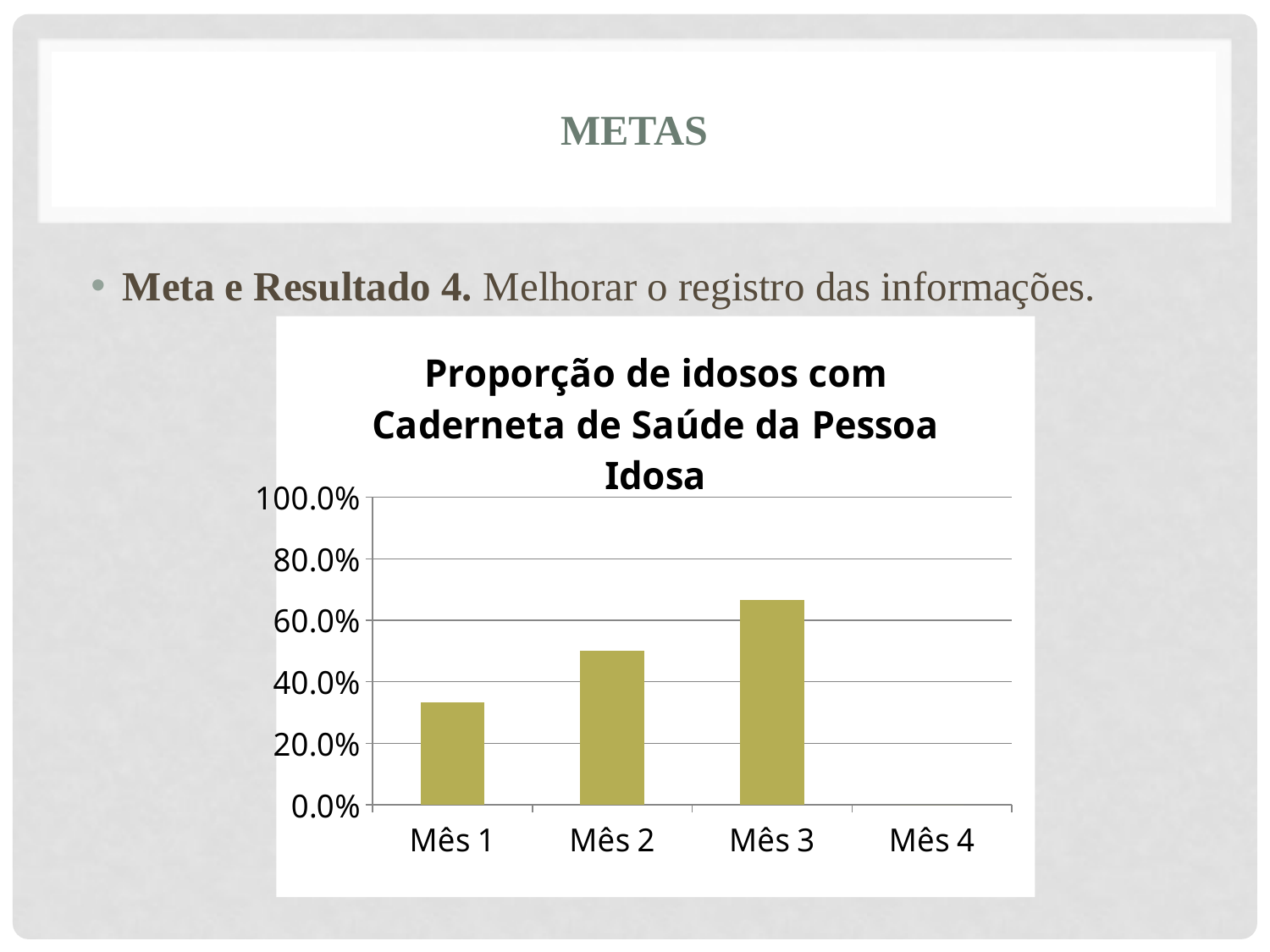
How many categories are shown on the x axis of the chart? 4 Is the value for Mês 1 greater or less than 20.0%? greater Which month has the lowest proportion in the chart? Mês 4 Is the value for Mês 2 greater or less than 40.0%? greater What type of chart is shown on the slide? bar chart Is the value for Mês 3 greater or less than 80.0%? less What is the title of the chart? Proporção de idosos com Caderneta de Saúde da Pessoa Idosa Which is larger, the value for Mês 2 or the value for Mês 1? Mês 2 Do the values rise or fall from Mês 1 to Mês 3? rise Which month has the highest proportion in the chart? Mês 3